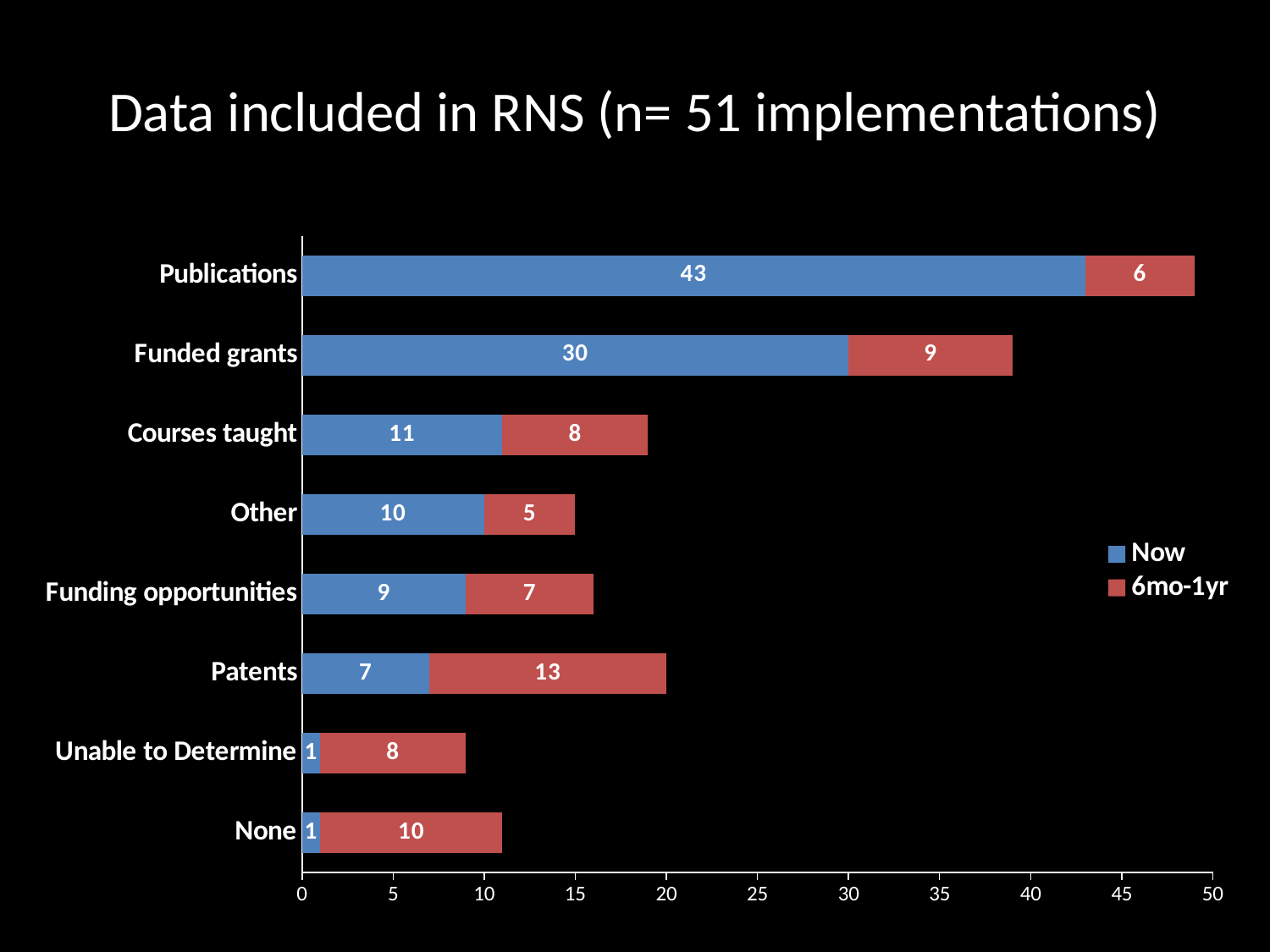
How many categories are shown on the chart? 8 What is the total of the stacked bar for Courses taught? 19 How many series does the legend list? 2 What is the 'Now' value for Publications? 43 Which category has the highest 'Now' value? Publications What is the 'Now' value for Funding opportunities? 9 What is the total of the stacked bar for Funded grants? 39 Which is larger for Patents: the 'Now' value or the '6mo-1yr' value? 6mo-1yr What kind of chart is shown on the slide? Stacked bar chart What is the '6mo-1yr' value for Patents? 13 Which category has the lowest '6mo-1yr' value? Other What is the difference between the 'Now' values for Publications and Funded grants? 13